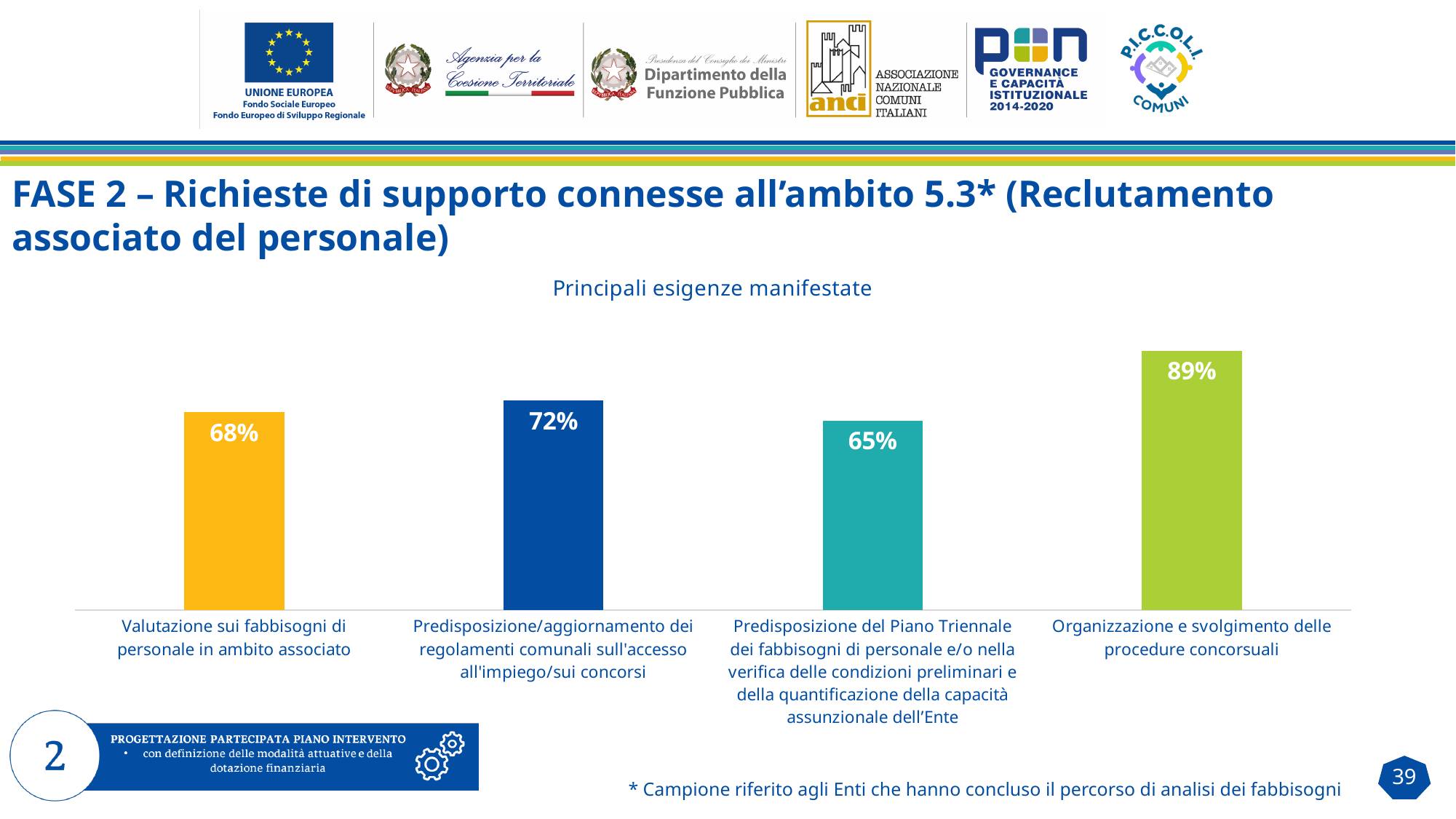
How many categories are shown in the chart? 4 What is the value for 'Organizzazione e svolgimento delle procedure concorsuali'? 89% What is the value for 'Predisposizione/aggiornamento dei regolamenti comunali sull'accesso all'impiego/sui concorsi'? 72% Which category has the lowest value? Predisposizione del Piano Triennale dei fabbisogni di personale e/o nella verifica delle condizioni preliminari e della quantificazione della capacità assunzionale dell'Ente Which is larger: the value for 'Valutazione sui fabbisogni di personale in ambito associato' or the value for 'Predisposizione/aggiornamento dei regolamenti comunali sull'accesso all'impiego/sui concorsi'? Predisposizione/aggiornamento dei regolamenti comunali sull'accesso all'impiego/sui concorsi What is the difference between the value for 'Organizzazione e svolgimento delle procedure concorsuali' and the value for 'Valutazione sui fabbisogni di personale in ambito associato'? 21% What kind of chart is shown on the slide? Bar chart Which category has the highest value? Organizzazione e svolgimento delle procedure concorsuali What is the title of the chart? Principali esigenze manifestate What is the difference between the value for 'Predisposizione/aggiornamento dei regolamenti comunali sull'accesso all'impiego/sui concorsi' and the value for 'Predisposizione del Piano Triennale dei fabbisogni di personale'? 7% What colour is the bar for 'Organizzazione e svolgimento delle procedure concorsuali'? Green What is the value for 'Valutazione sui fabbisogni di personale in ambito associato'? 68%